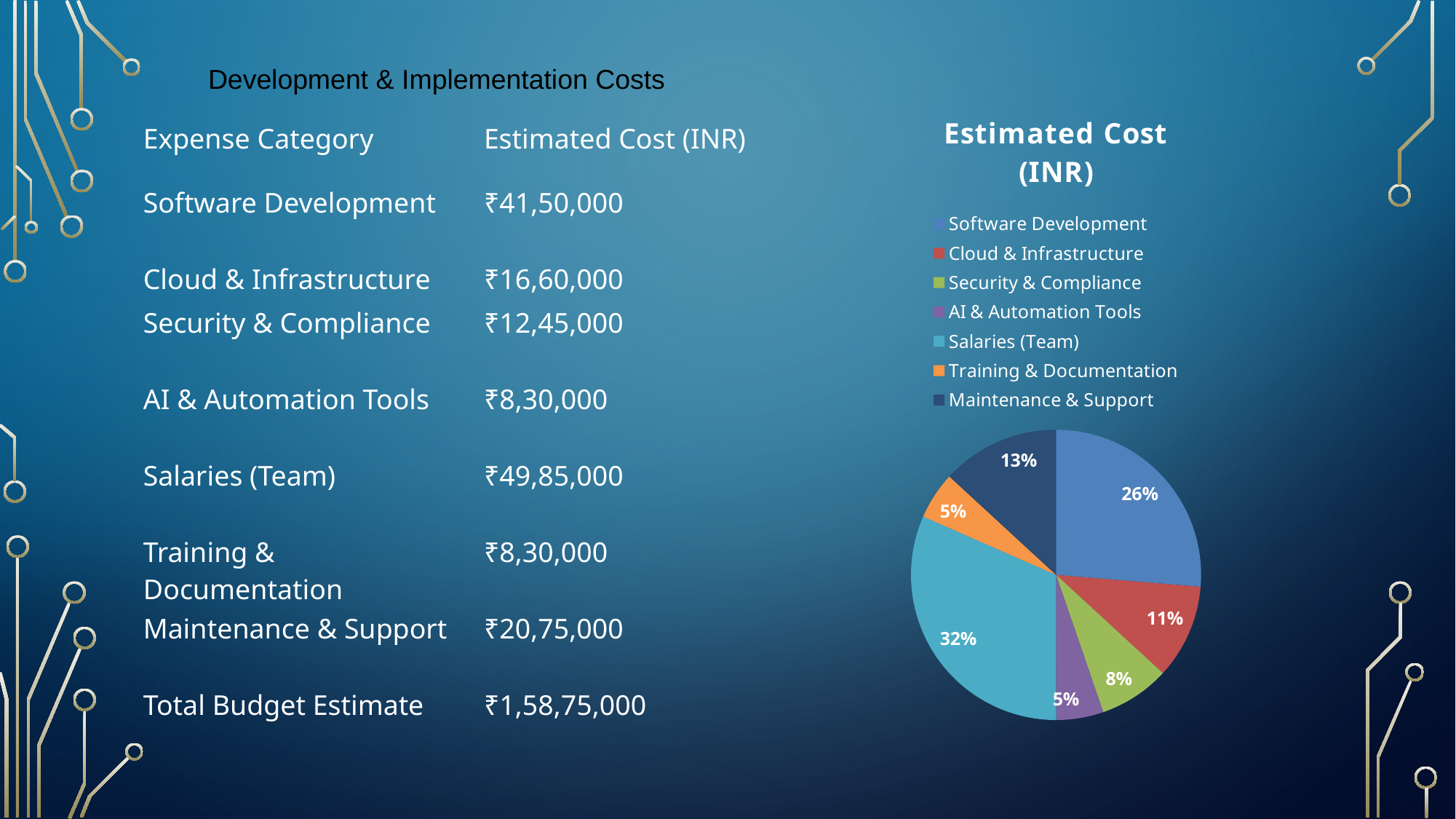
What share of the pie chart does Security & Compliance represent? 8% What type of chart is shown on the slide? pie chart What share of the pie chart does Salaries (Team) represent? 32% What share of the pie chart does Software Development represent? 26% Which is larger in the pie chart, the share for Cloud & Infrastructure or the share for Maintenance & Support? Maintenance & Support How many entries does the pie chart's legend list? 7 What is the difference in percentage points between the Salaries (Team) slice and the Software Development slice? 6 percentage points How many slices does the pie chart have? 7 What is the title of the pie chart? Estimated Cost (INR) Which category has the largest slice in the pie chart? Salaries (Team)